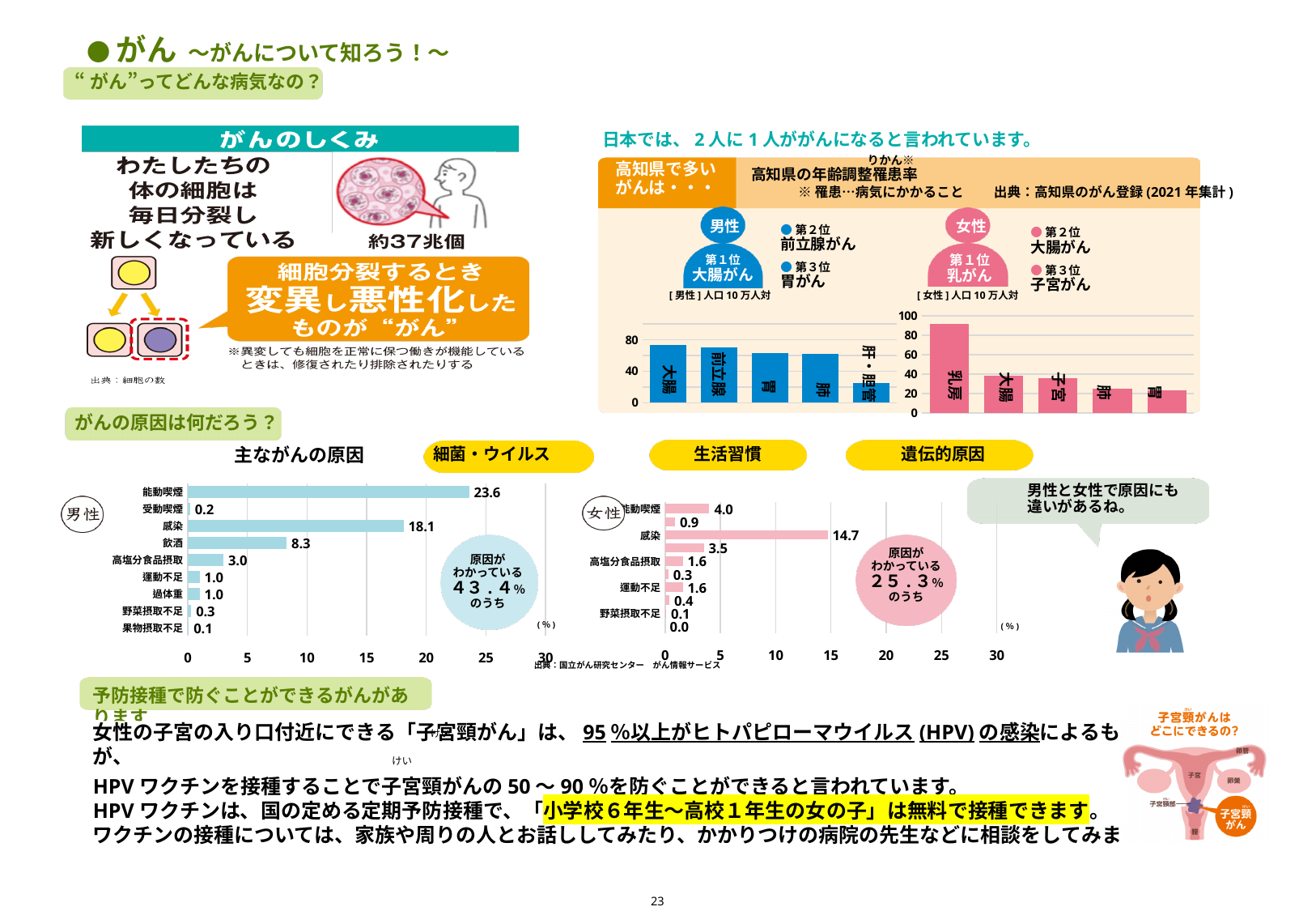
In the 主ながんの原因 chart for 男性, which cause has the lowest value? 果物摂取不足 In the 主ながんの原因 chart for 女性, what is the value for 感染? 14.7 In the 主ながんの原因 chart for 男性, what is the value for 感染? 18.1 In the 高知県の年齢調整罹患率 chart for 男性, is the value for 大腸 greater or less than 40? greater In the 主ながんの原因 chart for 男性, what is the value for 能動喫煙? 23.6 In the 主ながんの原因 chart for 女性, which cause has the highest value? 感染 In the 主ながんの原因 chart for 男性, what is the difference between 能動喫煙 and 感染? 5.5 In the 高知県の年齢調整罹患率 chart for 女性, is the value for 乳房 greater or less than 60? greater What kind of chart is the 主ながんの原因 chart for 男性? bar chart In the 主ながんの原因 chart for 男性, which cause has the highest value? 能動喫煙 In the 主ながんの原因 chart for 男性, which is larger, 飲酒 or 高塩分食品摂取? 飲酒 How many causes are listed in the 主ながんの原因 chart for 男性? 9